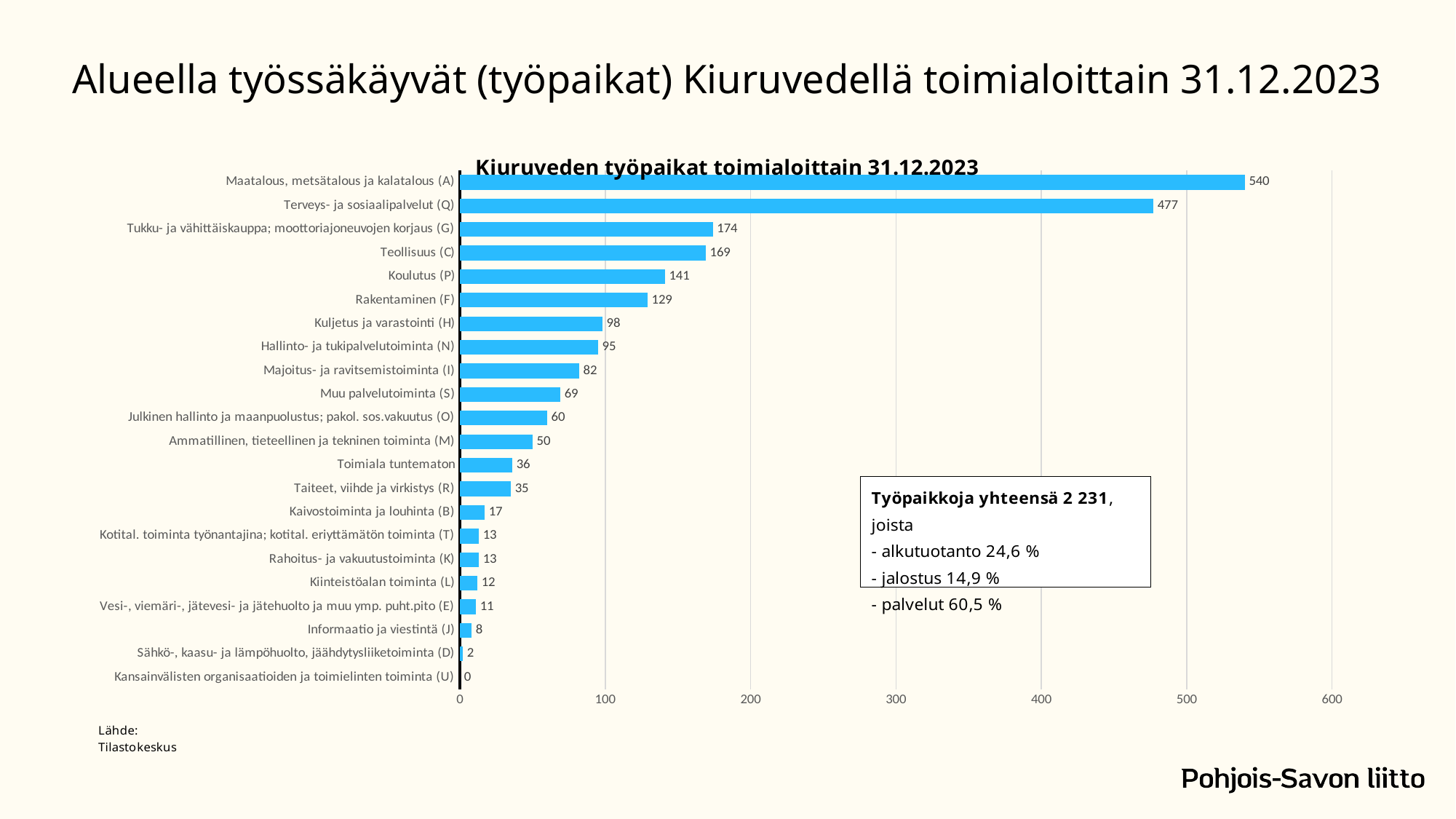
What is the difference between Maatalous, metsätalous ja kalatalous (A) and Terveys- ja sosiaalipalvelut (Q)? 63 What is the value for Kuljetus ja varastointi (H)? 98 What is the value for Maatalous, metsätalous ja kalatalous (A)? 540 What is the value for Majoitus- ja ravitsemistoiminta (I)? 82 Is the value for Tukku- ja vähittäiskauppa; moottoriajoneuvojen korjaus (G) greater or less than 200? less What kind of chart is shown on the slide? bar chart What is the title of the chart? Kiuruveden työpaikat toimialoittain 31.12.2023 Which category has the highest value? Maatalous, metsätalous ja kalatalous (A) Which category has the lowest value? Kansainvälisten organisaatioiden ja toimielinten toiminta (U) Which is larger, Teollisuus (C) or Rakentaminen (F)? Teollisuus (C) How many categories are shown in the chart? 22 What is the value for Koulutus (P)? 141